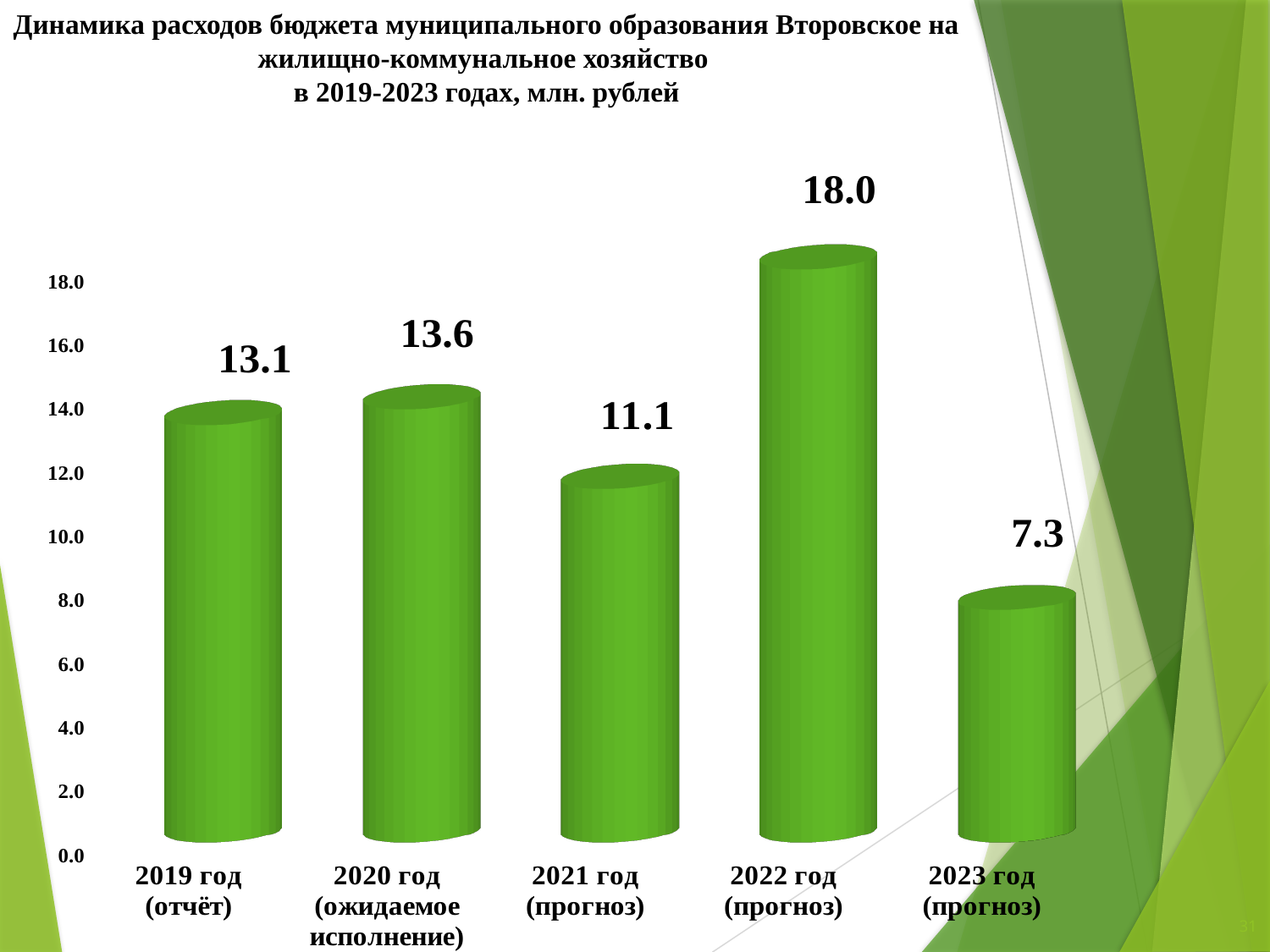
What is the value for 2019 год (отчёт)? 13.1 What is the difference between the values for 2022 год (прогноз) and 2021 год (прогноз)? 6.9 How many years are shown on the chart? 5 Which is larger, the value for 2020 год (ожидаемое исполнение) or the value for 2021 год (прогноз)? 2020 год (ожидаемое исполнение) What kind of chart is shown on the slide? bar chart What is the value for 2022 год (прогноз)? 18.0 What is the value for 2023 год (прогноз)? 7.3 Is the value for 2023 год (прогноз) greater or less than 8.0? less Which year has the highest value? 2022 год (прогноз) What unit of measurement is stated in the chart title? млн. рублей Which year has the lowest value? 2023 год (прогноз) What is the difference between the values for 2020 год (ожидаемое исполнение) and 2019 год (отчёт)? 0.5